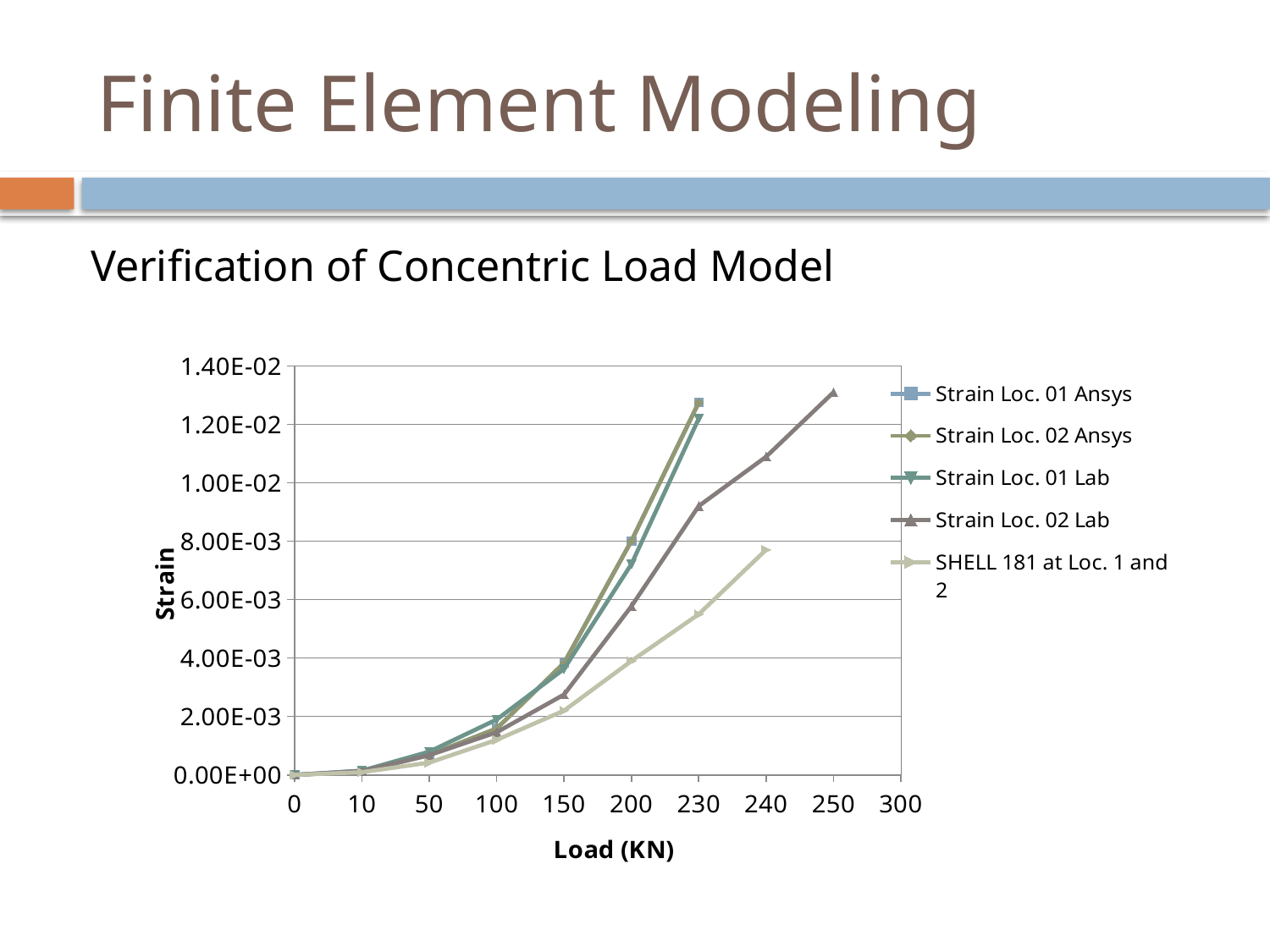
How many series does the legend list? 5 How many load values are marked along the x axis? 10 Is the value for Strain Loc. 02 Lab at a load of 230 greater or less than 8.00E-03? greater What is the title of the x axis? Load (KN) At a load of 230, which is larger: Strain Loc. 01 Ansys or Strain Loc. 02 Lab? Strain Loc. 01 Ansys Is the value for Strain Loc. 02 Lab at a load of 250 greater or less than 1.20E-02? greater Which series has the lowest strain at a load of 230? SHELL 181 at Loc. 1 and 2 Is the value for Strain Loc. 01 Ansys at a load of 230 greater or less than 1.20E-02? greater What kind of chart is shown on the slide? Line chart At a load of 240, which is larger: Strain Loc. 02 Lab or SHELL 181 at Loc. 1 and 2? Strain Loc. 02 Lab Does the strain for Strain Loc. 02 Lab rise or fall as the load increases? Rise